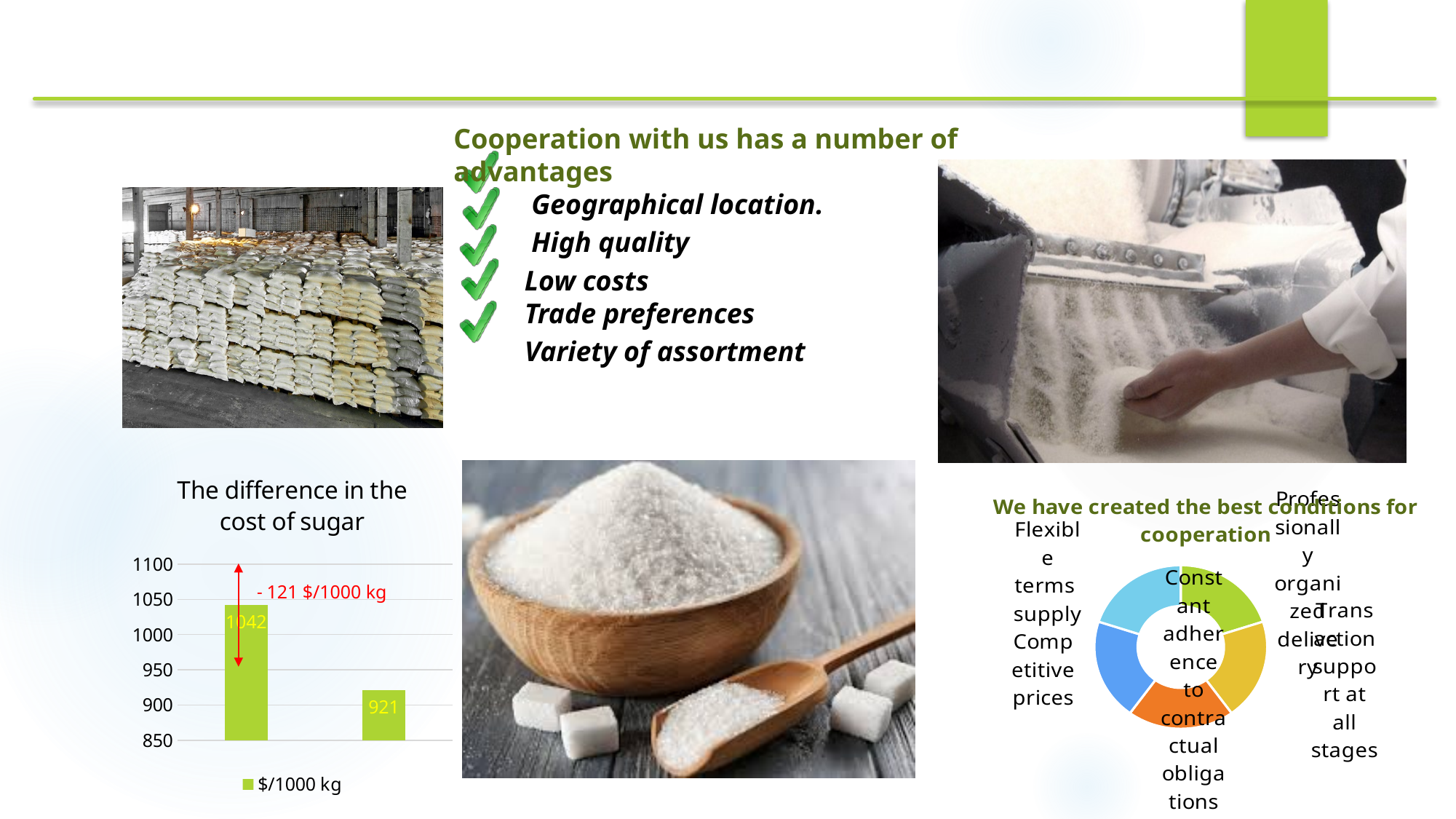
In the chart titled 'The difference in the cost of sugar', what is the difference between the two bars? 121 What kind of chart is 'The difference in the cost of sugar'? bar chart In the chart titled 'The difference in the cost of sugar', do the values rise or fall from left to right? fall In the chart titled 'The difference in the cost of sugar', how many series does the legend list? 1 In the chart titled 'The difference in the cost of sugar', how many bars are plotted? 2 In the chart titled 'The difference in the cost of sugar', what is the legend entry? $/1000 kg In the chart titled 'The difference in the cost of sugar', which bar is taller, the left or the right? left In the chart titled 'The difference in the cost of sugar', is the value of the right bar greater or less than 950? less In the doughnut chart on the right of the slide, how many segments are there? 5 In the chart titled 'The difference in the cost of sugar', what is the value of the right bar? 921 In the chart titled 'The difference in the cost of sugar', what is the value of the left bar? 1042 What is the title of the chart on the right of the slide? We have created the best conditions for cooperation